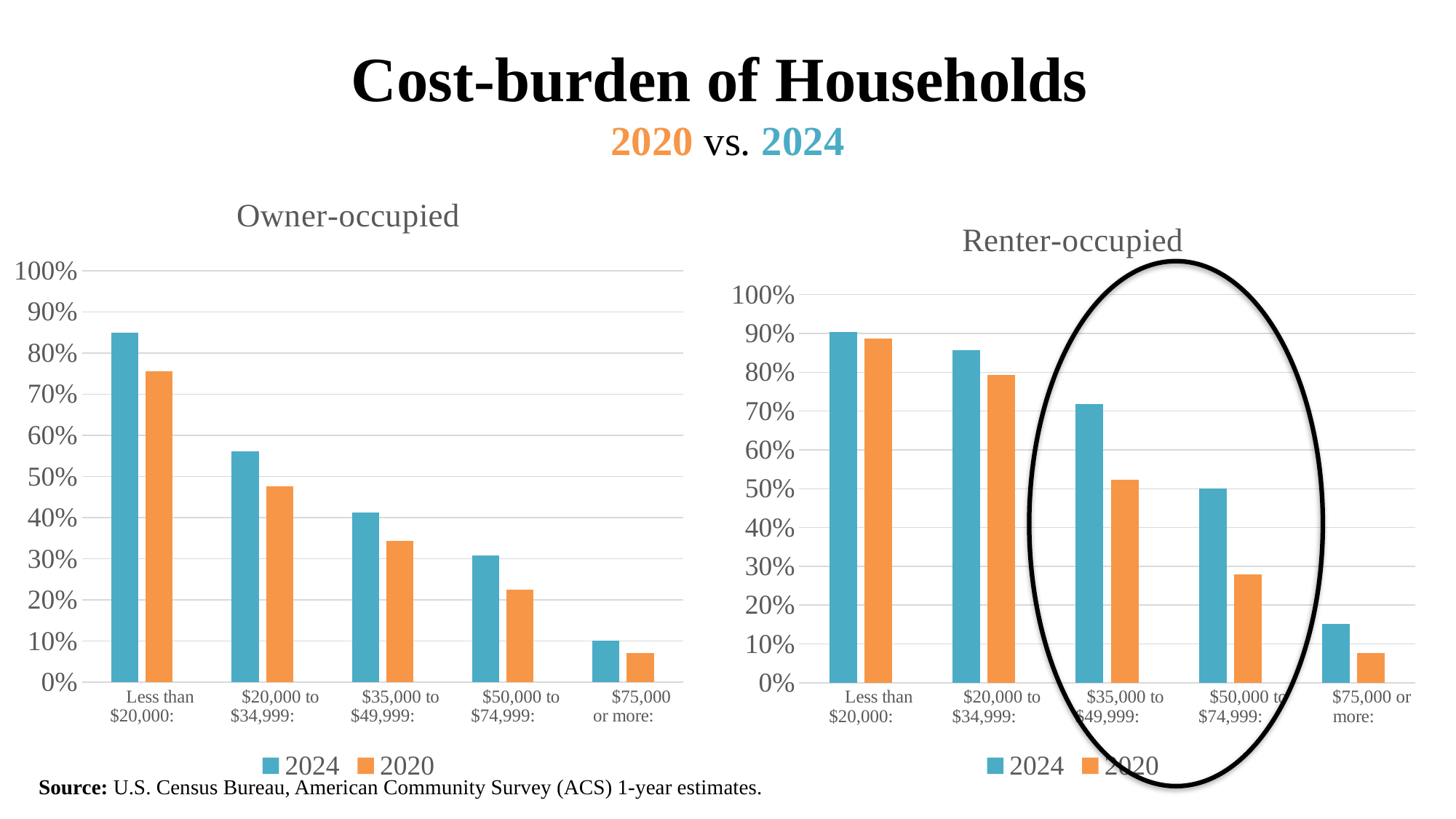
In the Renter-occupied chart, is the 2024 value for $35,000 to $49,999 greater or less than 60%? greater How many income categories are shown on the x axis of the Renter-occupied chart? 5 In the Owner-occupied chart, is the 2020 value for $75,000 or more greater or less than 10%? less In the Renter-occupied chart, is the 2020 value for $50,000 to $74,999 greater or less than 30%? less In the Owner-occupied chart, do the 2024 values rise or fall as income increases along the x axis? fall How many series does the legend of the Owner-occupied chart list? 2 In the Renter-occupied chart, which income category has the lowest 2020 value? $75,000 or more What kind of chart is the Owner-occupied chart? bar chart Which colour represents 2020 in the legend of the Renter-occupied chart? orange In the Owner-occupied chart, which income category has the highest 2024 value? Less than $20,000 In the Renter-occupied chart, for $50,000 to $74,999, which is larger: the 2024 value or the 2020 value? 2024